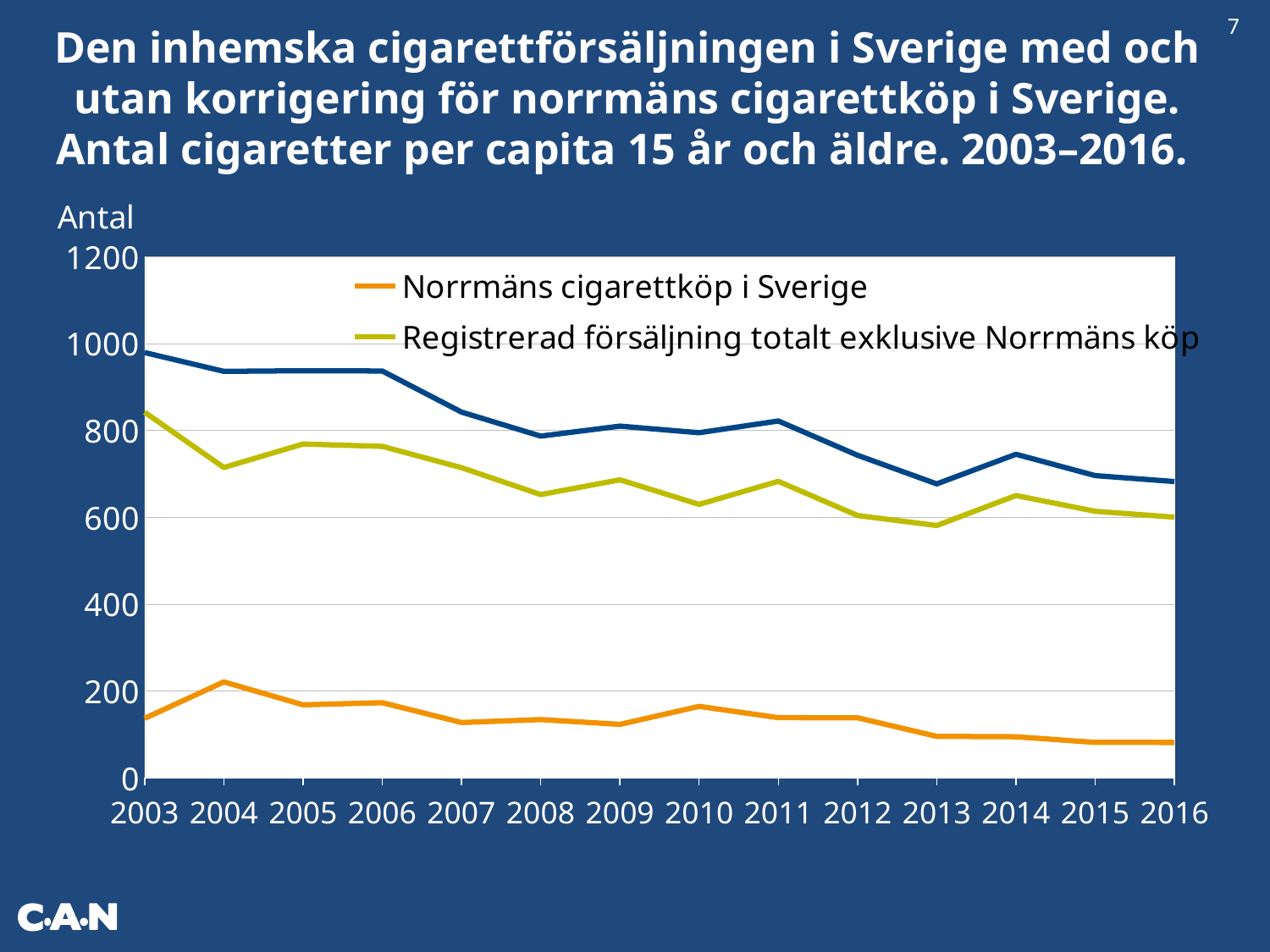
Is the value for 'Norrmäns cigarettköp i Sverige' in 2016 greater or less than 100? less Does the value for 'Registrerad försäljning totalt exklusive Norrmäns köp' generally rise or fall from 2003 to 2016? Fall What colour is the line for 'Norrmäns cigarettköp i Sverige'? Orange Is the value for 'Registrerad försäljning totalt exklusive Norrmäns köp' in 2013 greater or less than 600? less How many years are shown on the x axis? 14 For 'Registrerad försäljning totalt exklusive Norrmäns köp', which year has the larger value, 2004 or 2005? 2005 Is the value for 'Registrerad försäljning totalt exklusive Norrmäns köp' in 2003 greater or less than 800? greater What kind of chart is shown on the slide? Line chart In which year is the value for 'Registrerad försäljning totalt exklusive Norrmäns köp' highest? 2003 In which year is the value for 'Norrmäns cigarettköp i Sverige' highest? 2004 How many series does the legend list? 2